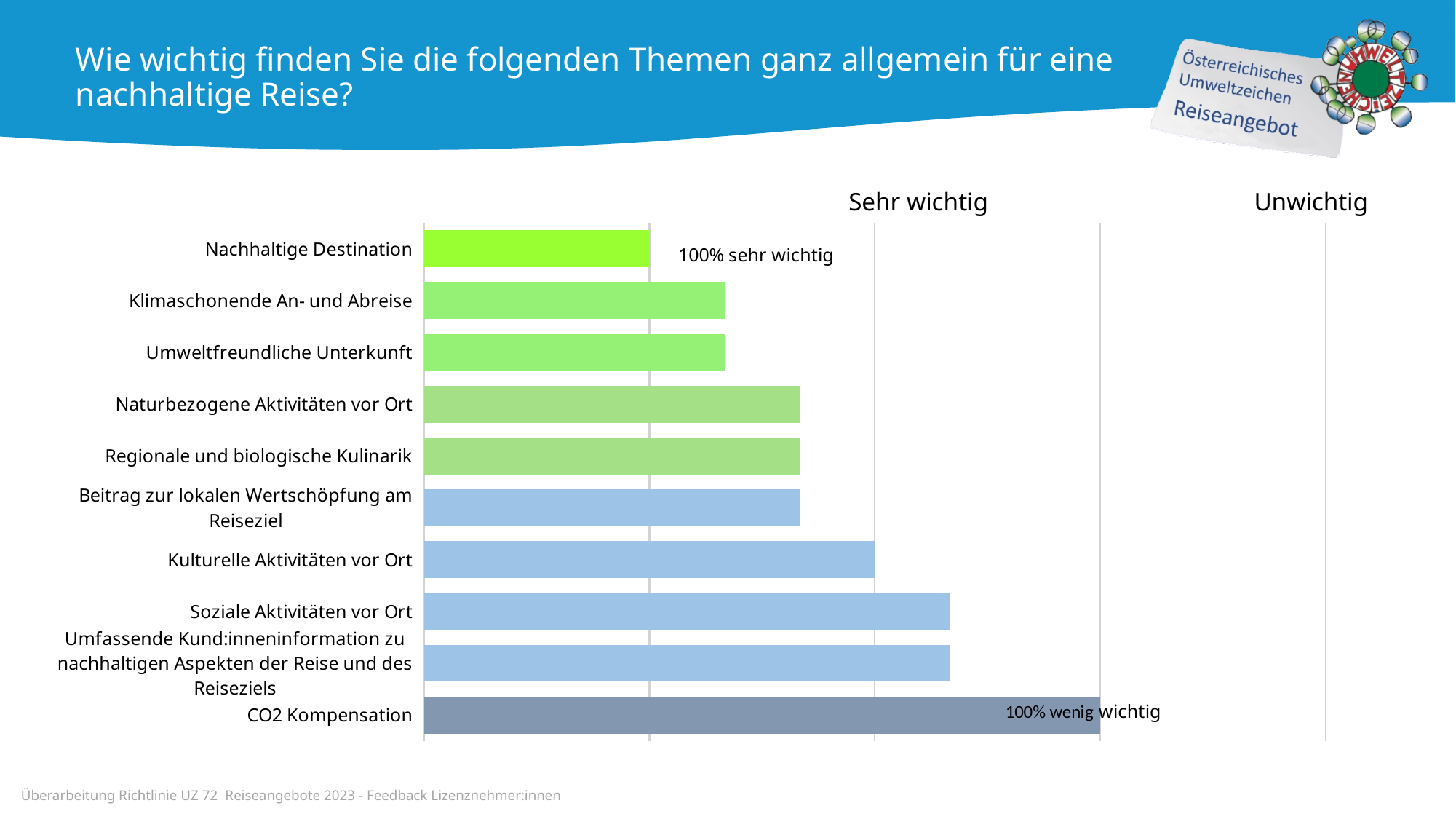
What data label is printed on the bar for CO2 Kompensation? 100% wenig wichtig Which bar is longer: Soziale Aktivitäten vor Ort or Naturbezogene Aktivitäten vor Ort? Soziale Aktivitäten vor Ort Do the bars get longer or shorter going from the top category to the bottom category? Longer Which category has the longest bar in the chart? CO2 Kompensation Which bar is longer: Kulturelle Aktivitäten vor Ort or Klimaschonende An- und Abreise? Kulturelle Aktivitäten vor Ort What question is posed in the slide title? Wie wichtig finden Sie die folgenden Themen ganz allgemein für eine nachhaltige Reise? Which bar is shorter: Umweltfreundliche Unterkunft or Beitrag zur lokalen Wertschöpfung am Reiseziel? Umweltfreundliche Unterkunft What kind of chart is shown on the slide? Bar chart What data label is printed next to the bar for Nachhaltige Destination? 100% sehr wichtig How many categories (topics) are plotted in the chart? 10 Which category has the shortest bar in the chart? Nachhaltige Destination What are the two labels shown above the chart marking the ends of the importance scale? Sehr wichtig and Unwichtig